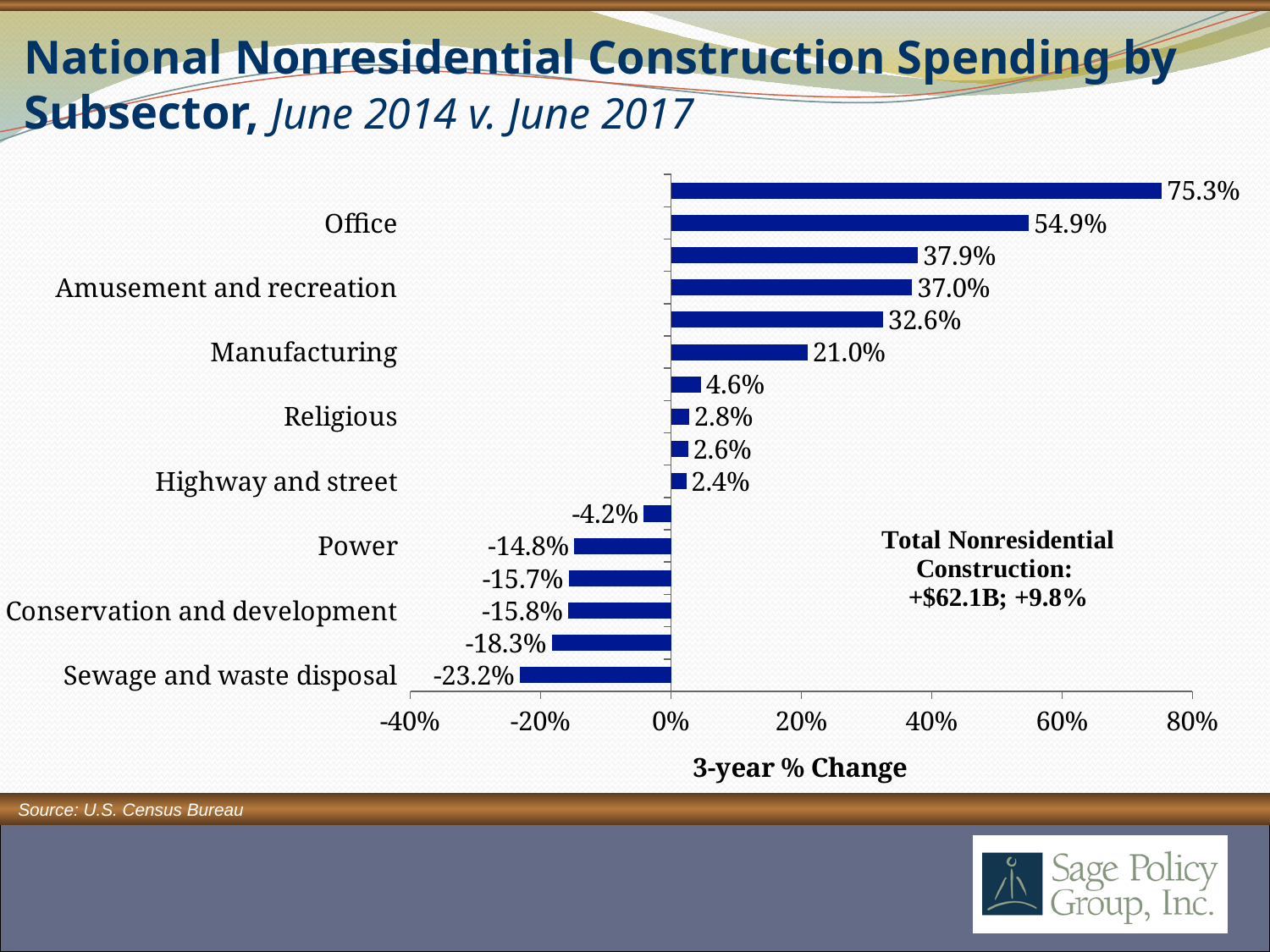
What is the title of the horizontal axis? 3-year % Change What is the 3-year % change for Manufacturing? 21.0% What kind of chart is shown on the slide? Bar chart How many bars are plotted in the chart? 16 Is the value for Conservation and development greater or less than 0%? less What is the 3-year % change for Amusement and recreation? 37.0% How many percentage points higher is the 3-year % change for Office than for Amusement and recreation? 17.9 percentage points Which labeled subsector has the lowest 3-year % change? Sewage and waste disposal What is the 3-year % change for Office? 54.9% Which has the larger 3-year % change, Religious or Highway and street? Religious What is the 3-year % change for Power? -14.8% What is the 3-year % change for Sewage and waste disposal? -23.2%